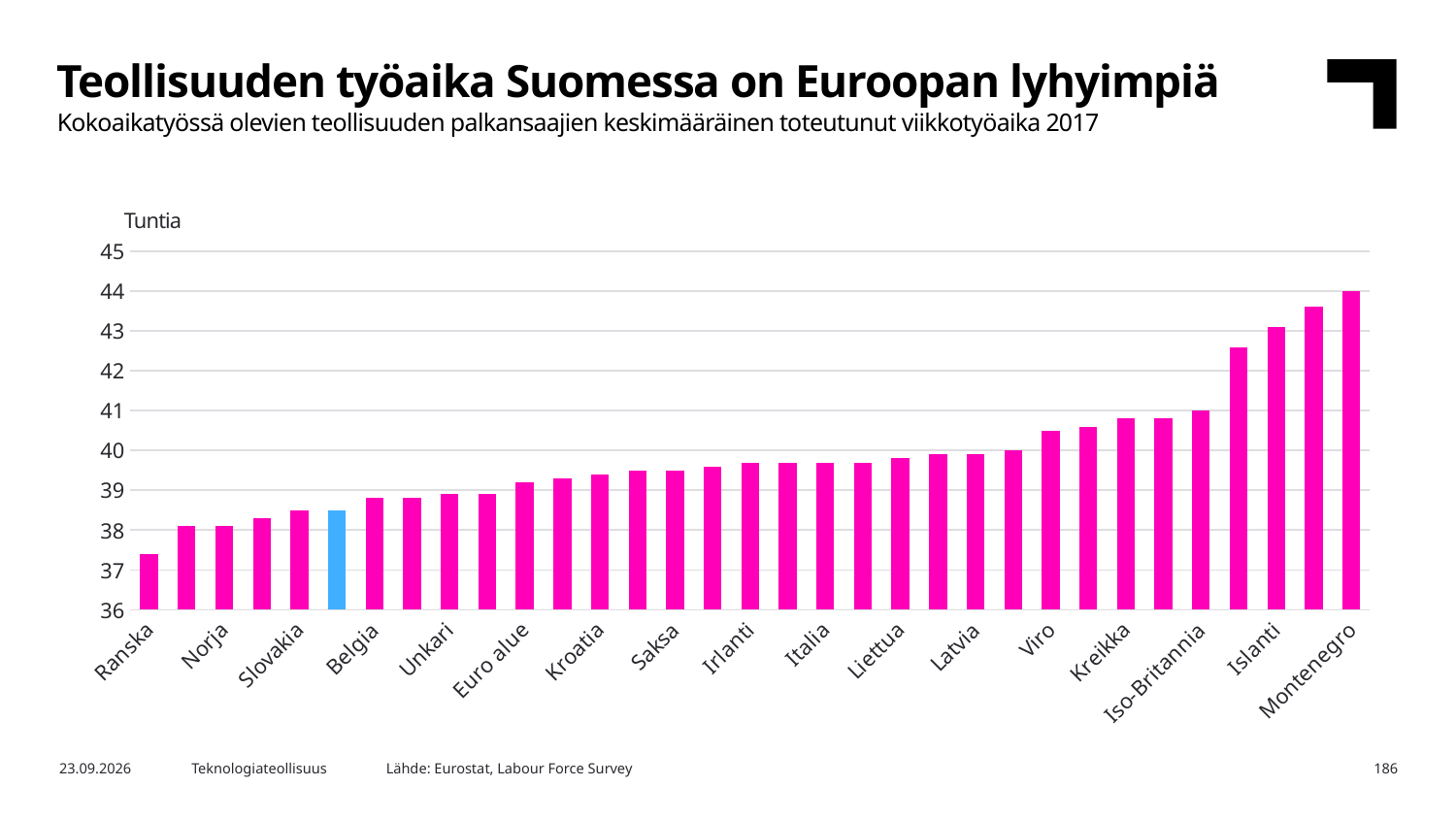
Is the value for Kreikka greater or less than 40? greater Is the value for Ranska greater or less than 38? less Is the value for Montenegro greater or less than 43? greater Which country has the highest average weekly working time in the chart? Montenegro Which country has the lowest average weekly working time in the chart? Ranska What unit is shown above the vertical axis of the chart? Tuntia What kind of chart is shown on the slide? bar chart Which has a larger value, Islanti or Saksa? Islanti Do the bar values rise or fall from left to right along the x axis? rise